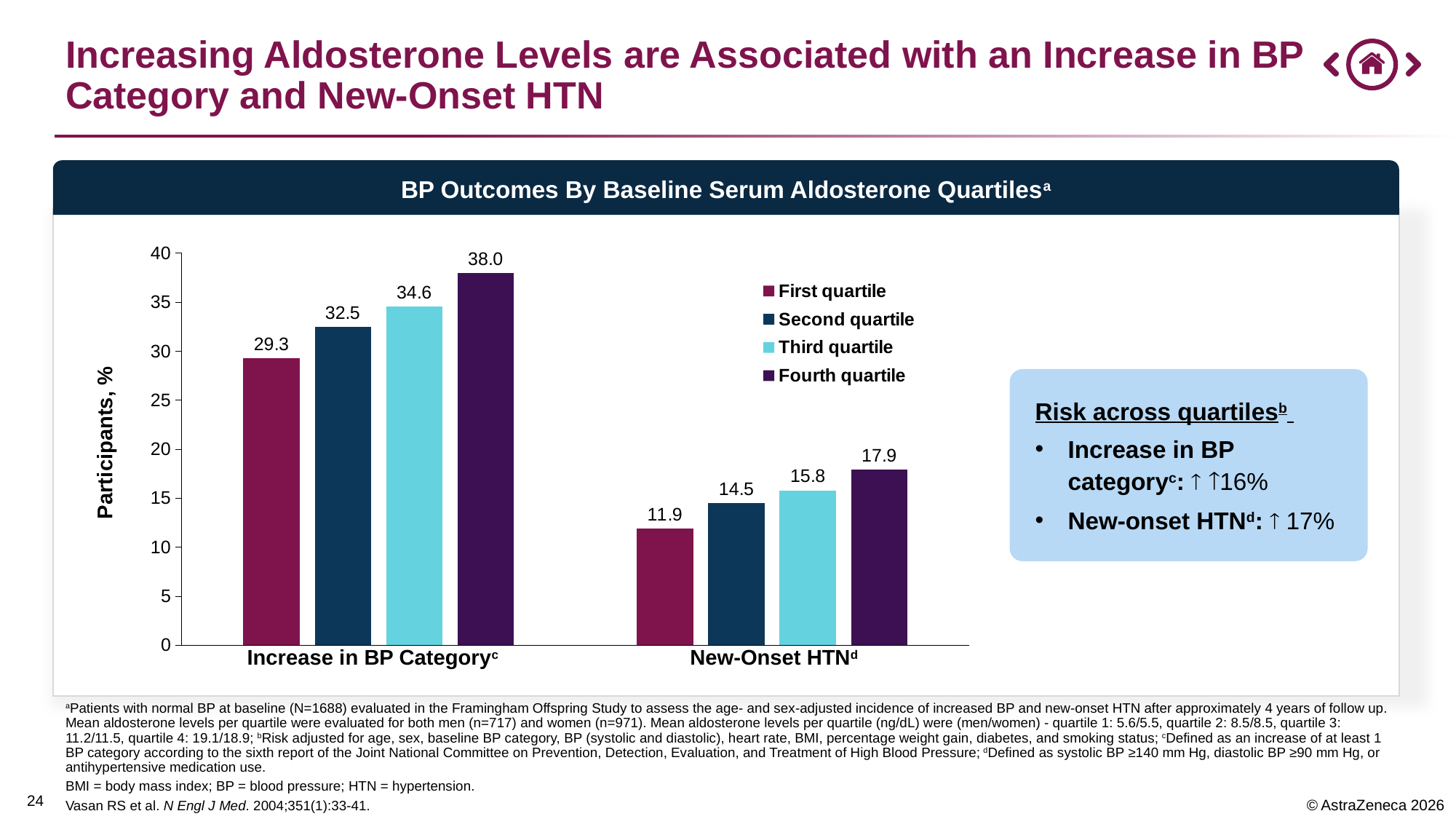
What is the value for the Third quartile in the Increase in BP Category group? 34.6 What is the value for the First quartile in the New-Onset HTN group? 11.9 What is the difference between the Fourth quartile and First quartile values in the Increase in BP Category group? 8.7 How many series does the legend list? 4 What is the label of the y axis? Participants, % What is the value for the Fourth quartile in the Increase in BP Category group? 38.0 How many categories are shown on the x axis? 2 Which quartile has the highest value in the New-Onset HTN group? Fourth quartile Which is larger: the Second quartile value for Increase in BP Category or the Fourth quartile value for New-Onset HTN? Second quartile value for Increase in BP Category What is the difference between the Second quartile and First quartile values in the New-Onset HTN group? 2.6 What kind of chart is shown on the slide? Bar chart Which quartile has the lowest value in the Increase in BP Category group? First quartile